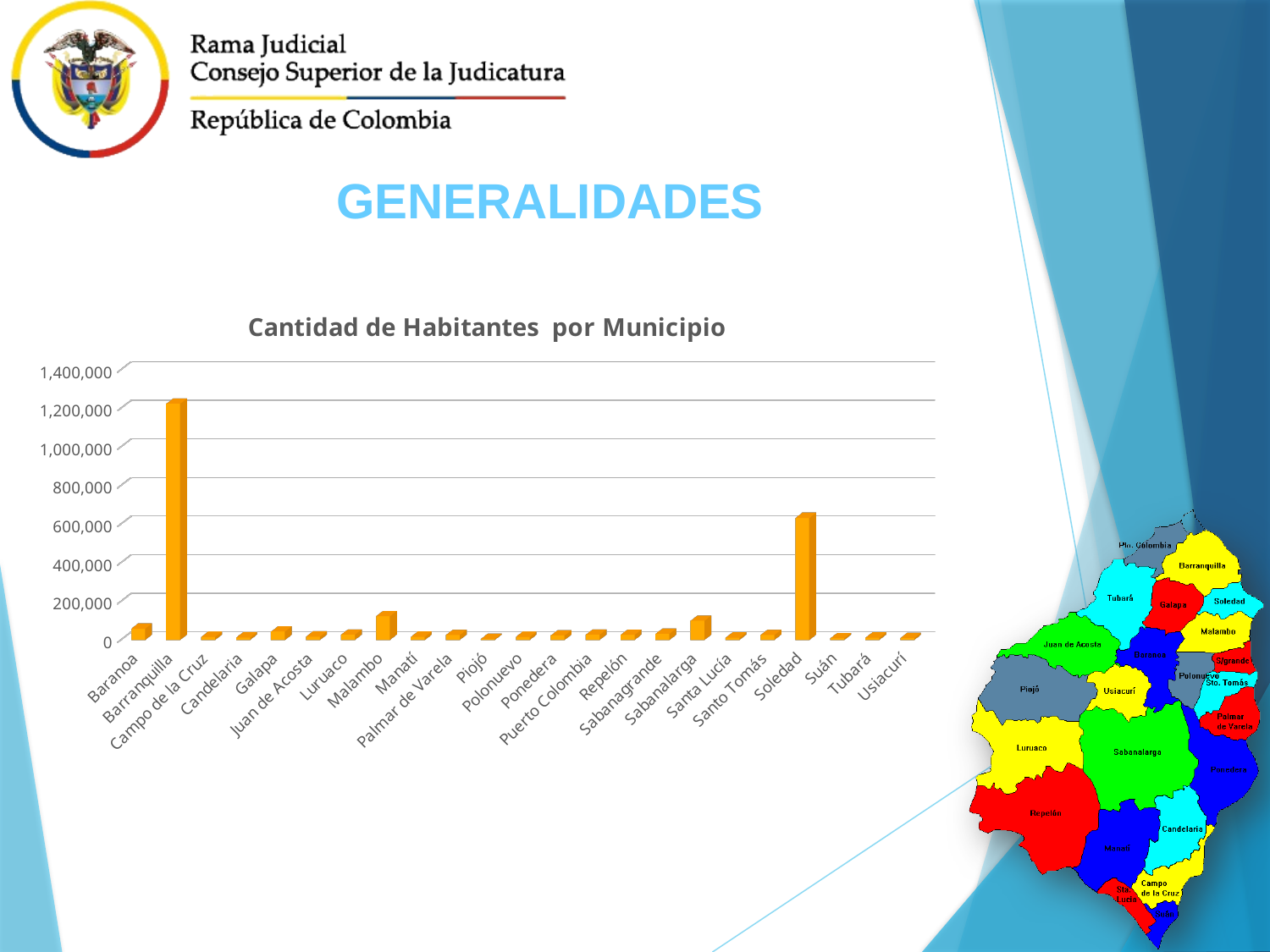
Which has more inhabitants, Barranquilla or Soledad? Barranquilla Is the value for Soledad greater or less than 800,000? less Is the value for Sabanalarga greater or less than 200,000? less Which municipality has the second-highest number of inhabitants in the chart? Soledad Which has more inhabitants, Soledad or Malambo? Soledad Is the value for Barranquilla greater or less than 1,000,000? greater What kind of chart is shown on the slide? bar chart What is the title of the chart? Cantidad de Habitantes por Municipio How many municipalities are shown on the x axis of the chart? 23 Which municipality has the highest number of inhabitants in the chart? Barranquilla